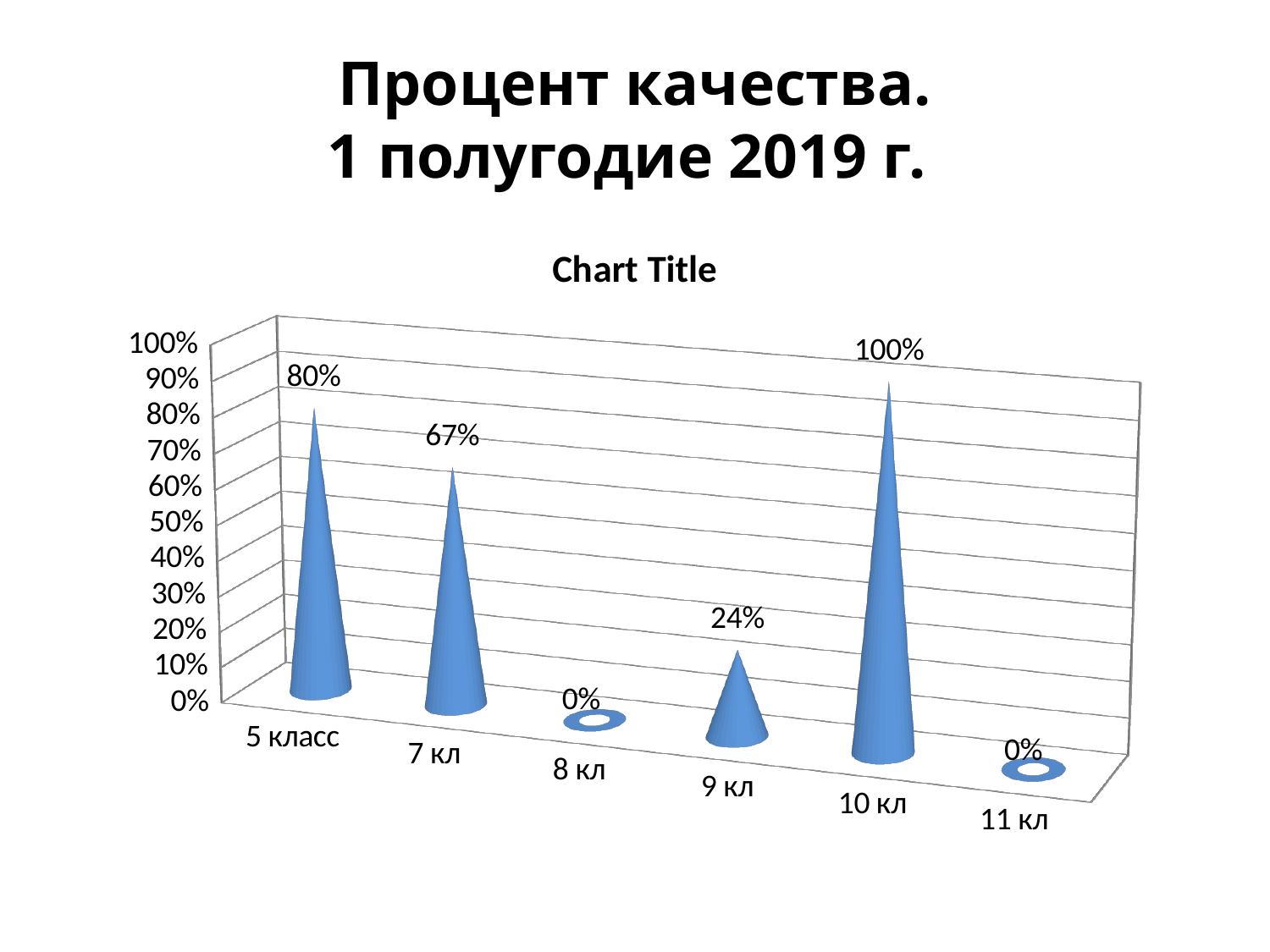
What is the title shown above the chart area? Chart Title What is the difference between the values for 10 кл and 9 кл? 76% How many categories are shown on the x axis? 6 Which categories have a value of 0%? 8 кл and 11 кл What is the difference between the values for 5 класс and 7 кл? 13% What is the value for 7 кл? 67% What is the value for 5 класс? 80% What kind of chart is this? bar chart Which category has the highest value? 10 кл Which is larger, the value for 7 кл or the value for 9 кл? 7 кл What is the value for 10 кл? 100% What is the value for 9 кл? 24%